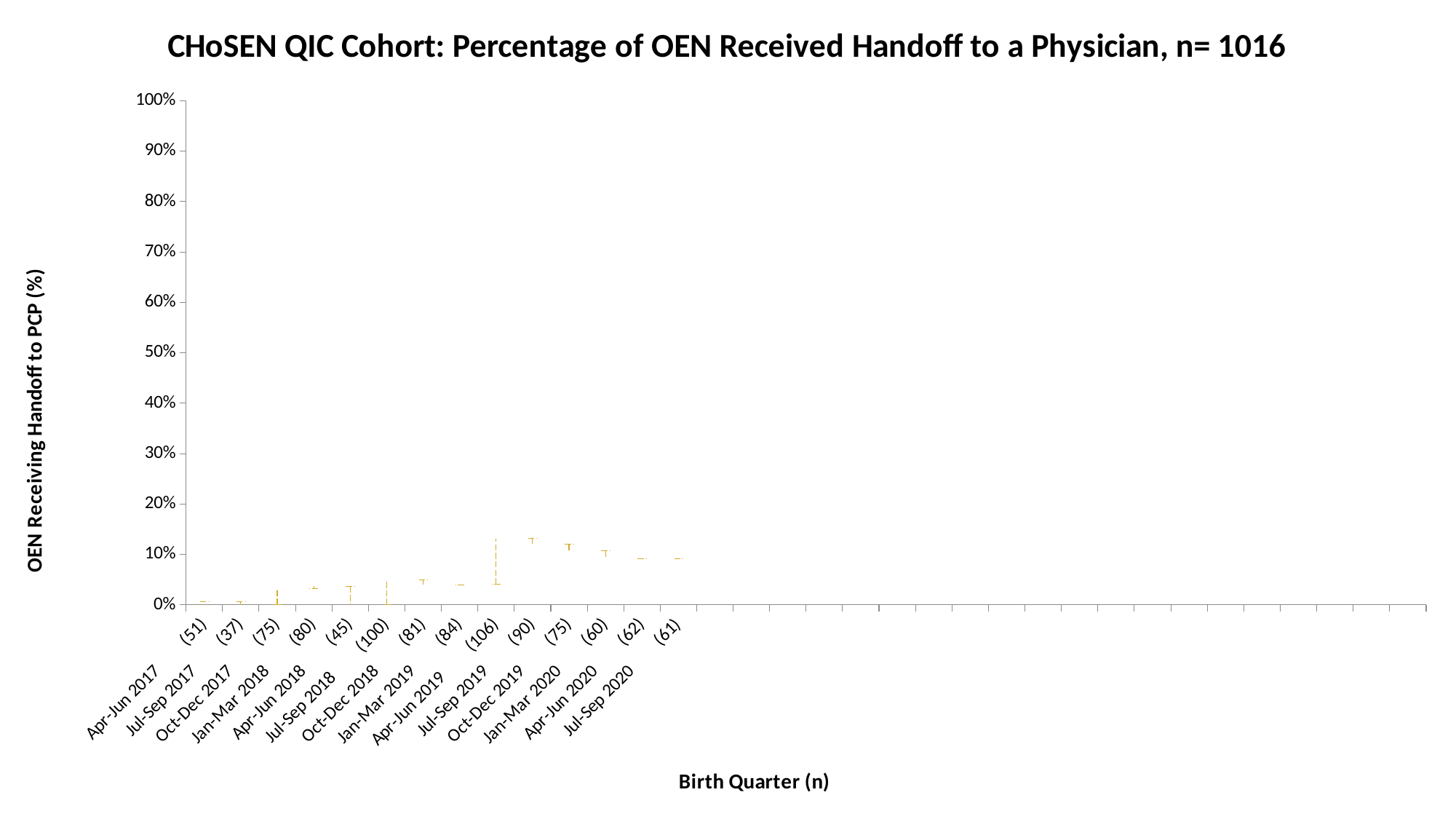
How many birth quarters are plotted on the x axis? 14 What is the n shown for the Apr-Jun 2019 birth quarter? 106 What is the label of the y axis? OEN Receiving Handoff to PCP (%) What kind of chart is this? line chart What is the title of the chart? CHoSEN QIC Cohort: Percentage of OEN Received Handoff to a Physician, n= 1016 What is the n shown for the Jul-Sep 2018 birth quarter? 100 Is the value for Oct-Dec 2019 greater or less than 10%? greater Which is larger, the value for Oct-Dec 2019 or the value for Jul-Sep 2017? Oct-Dec 2019